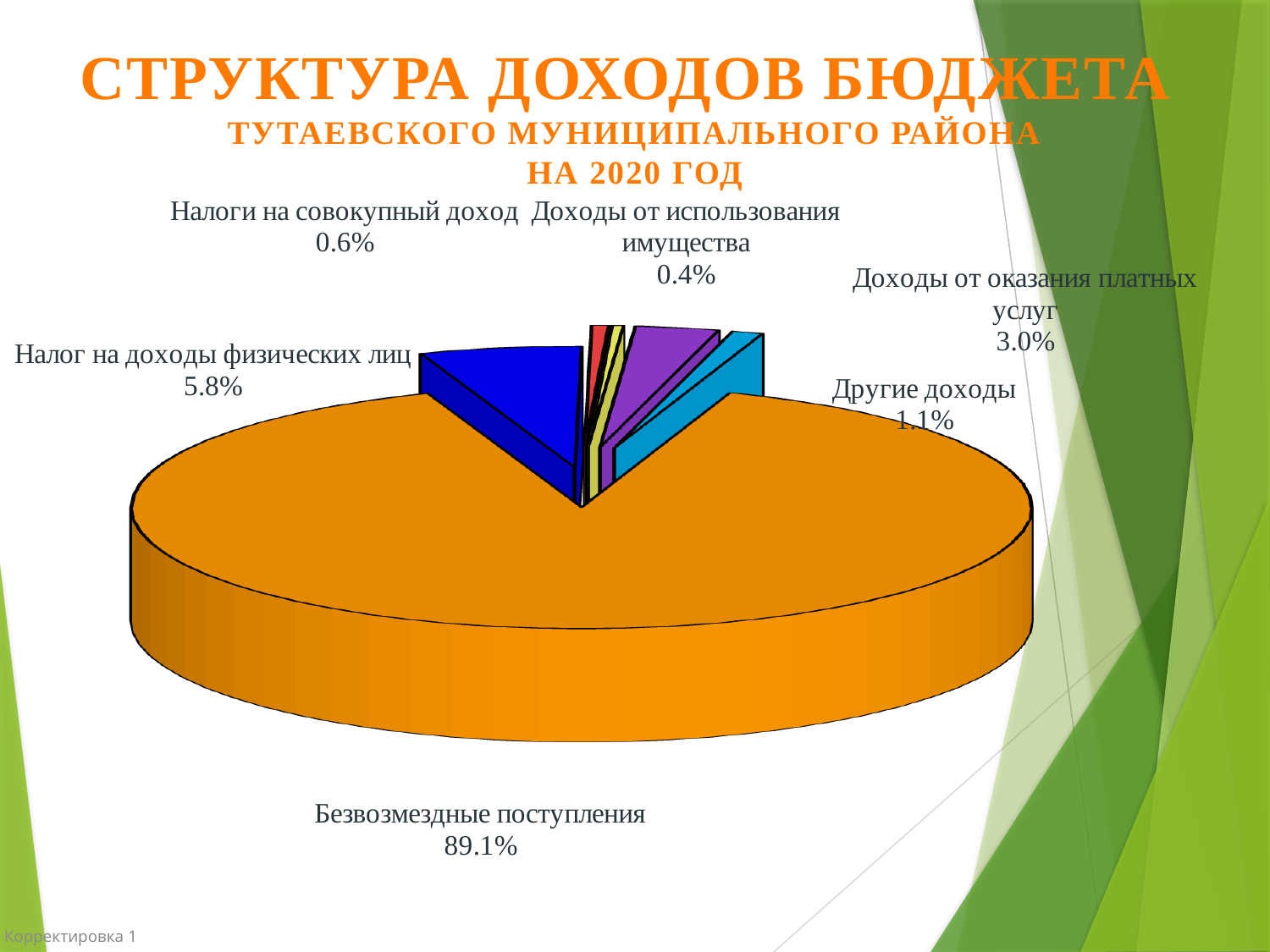
What share of budget revenue is labelled for Безвозмездные поступления? 89.1% What kind of chart is shown on the slide? Pie chart How many slices does the pie chart have? 6 Which is larger: Налоги на совокупный доход or Другие доходы? Другие доходы What is the difference between the shares of Налог на доходы физических лиц and Доходы от оказания платных услуг? 2.8% For which year does the chart show the budget revenue structure? 2020 What percentage is shown for Доходы от оказания платных услуг? 3.0% What percentage is shown for Доходы от использования имущества? 0.4% Which category has the largest share of the pie? Безвозмездные поступления What is the value shown for Налог на доходы физических лиц? 5.8% Which category has the smallest share of the pie? Доходы от использования имущества What is the value labelled for Другие доходы? 1.1%